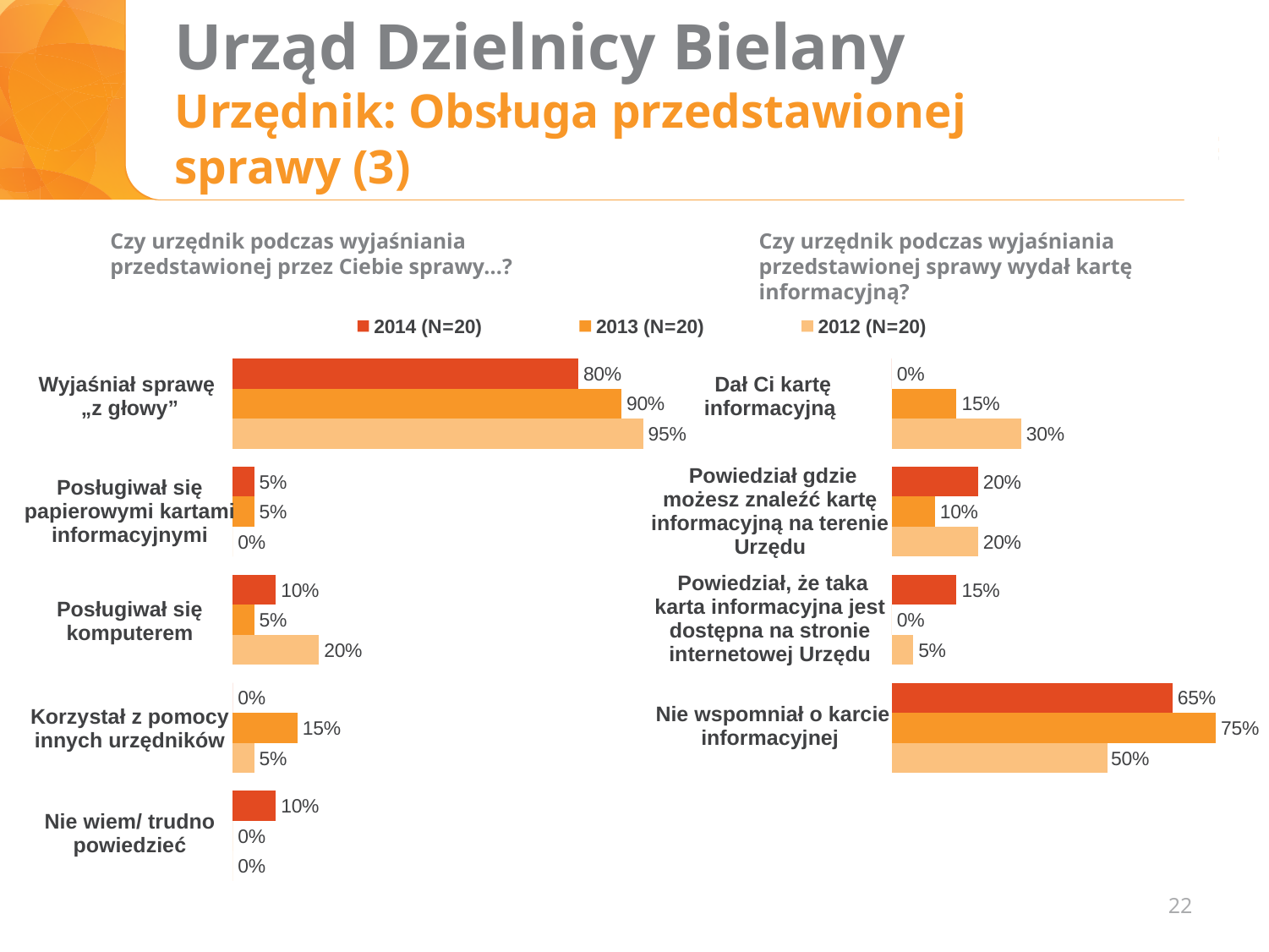
In the right chart, what is the 2012 (N=20) value for "Dał Ci kartę informacyjną"? 30% In the right chart ("Czy urzędnik podczas wyjaśniania przedstawionej sprawy wydał kartę informacyjną?"), what is the 2013 (N=20) value for "Nie wspomniał o karcie informacyjnej"? 75% How many series does the legend list? 3 In the left chart, which is larger for "Korzystał z pomocy innych urzędników": the 2013 value or the 2012 value? 2013 In the left chart, what is the difference between the 2012 and 2014 values for "Wyjaśniał sprawę „z głowy”"? 15% In the right chart, which category has the lowest 2014 (N=20) value? Dał Ci kartę informacyjną In the left chart ("Czy urzędnik podczas wyjaśniania przedstawionej przez Ciebie sprawy...?"), what is the 2014 (N=20) value for "Wyjaśniał sprawę „z głowy”"? 80% In the right chart, what is the difference between the 2013 and 2012 values for "Nie wspomniał o karcie informacyjnej"? 25% What type of chart is the left chart? Bar chart In the left chart, what is the 2012 (N=20) value for "Posługiwał się komputerem"? 20% In the left chart, which category has the highest 2012 (N=20) value? Wyjaśniał sprawę „z głowy” How many categories does the right chart show? 4